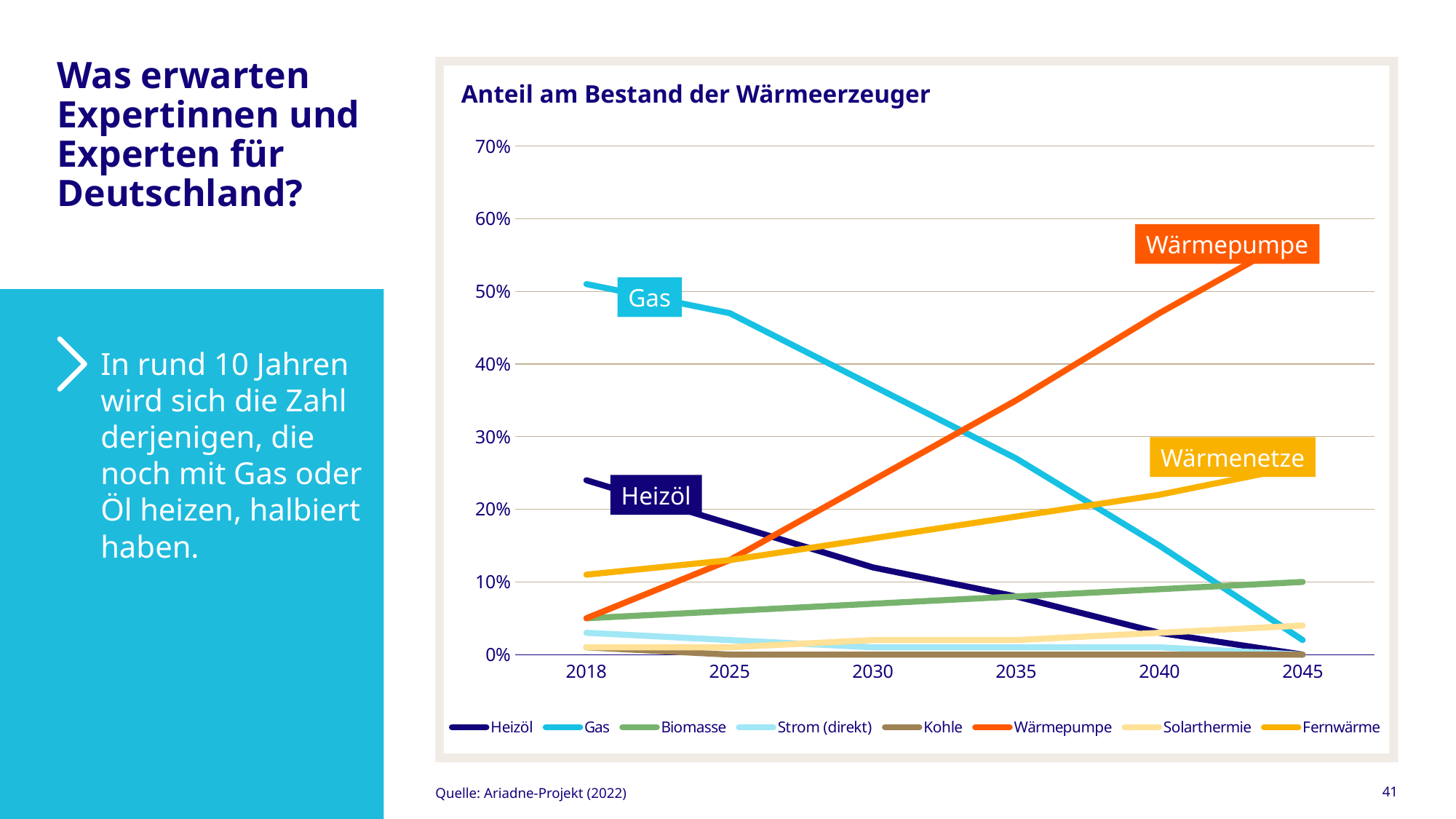
Is the value for Gas in 2018 greater or less than 40%? greater What is the title of the chart? Anteil am Bestand der Wärmeerzeuger Is the value for Heizöl in 2018 greater or less than 20%? greater Does the Wärmepumpe line rise or fall from 2018 to 2045? rise Which series has the highest value in 2045? Wärmepumpe How many series does the legend of the chart list? 8 How many years are marked on the x axis of the chart? 6 In 2045, which is larger: Wärmepumpe or Gas? Wärmepumpe Does the Gas line rise or fall from 2018 to 2045? fall What kind of chart is shown on the slide? line chart Is the value for Wärmepumpe in 2045 greater or less than 50%? greater